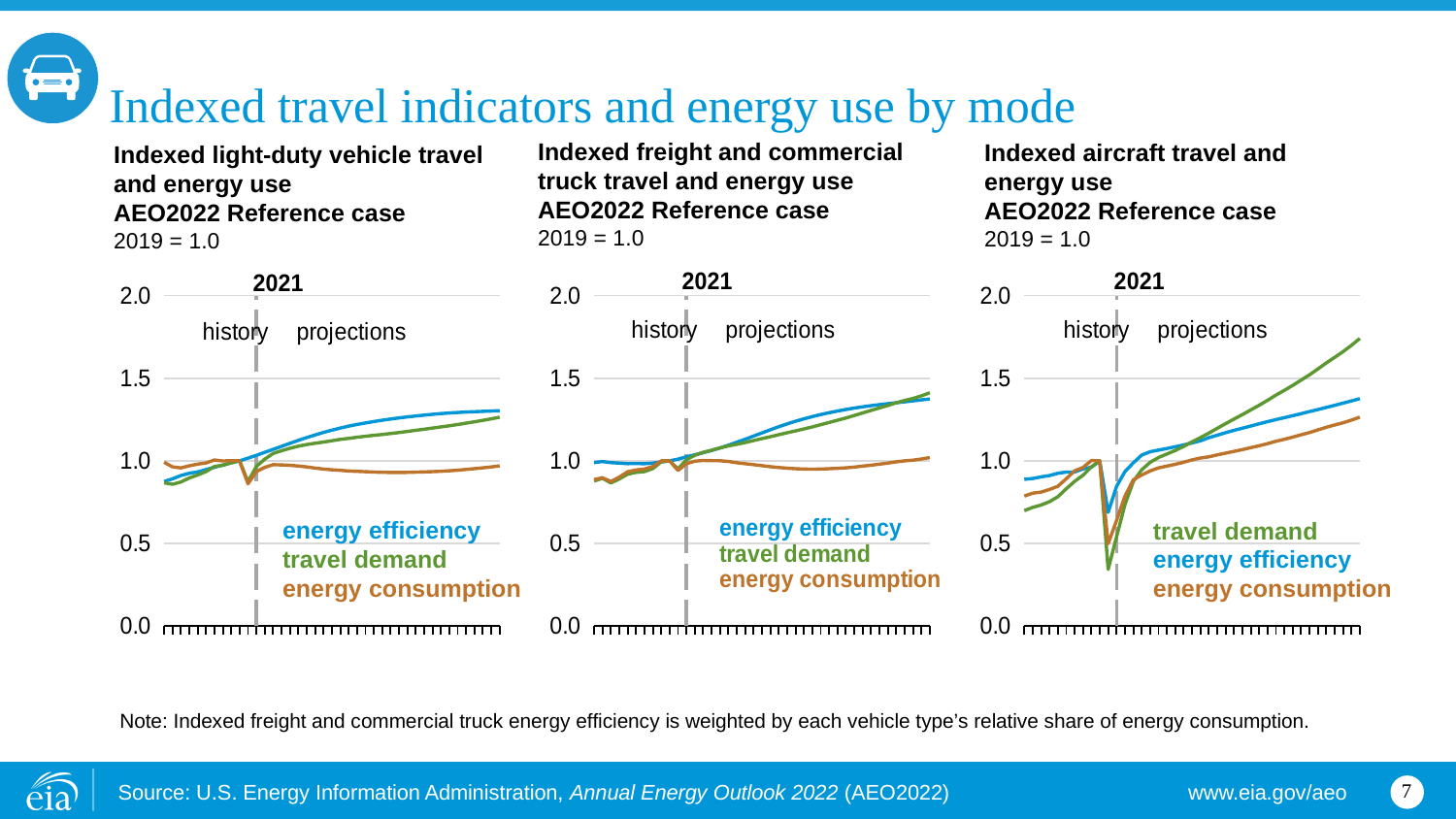
In the 'Indexed aircraft travel and energy use' chart, is the value for travel demand at the end of the projection period greater or less than 1.5? greater In the 'Indexed light-duty vehicle travel and energy use' chart, does energy efficiency rise or fall over the projection period? rise In the 'Indexed aircraft travel and energy use' chart, how many series are plotted? 3 What year does the vertical dashed line separating history from projections mark in each chart? 2021 In the 'Indexed aircraft travel and energy use' chart, at the end of the projection period, which is larger: travel demand or energy consumption? travel demand What kind of chart is the 'Indexed light-duty vehicle travel and energy use' chart? line chart In the 'Indexed freight and commercial truck travel and energy use' chart, which three series are labeled? energy efficiency, travel demand, energy consumption In the 'Indexed freight and commercial truck travel and energy use' chart, at the end of the projection period, which is larger: energy efficiency or energy consumption? energy efficiency In the 'Indexed aircraft travel and energy use' chart, which series is highest at the end of the projection period? travel demand How many charts are shown on the slide? 3 In the 'Indexed aircraft travel and energy use' chart, is the lowest value of travel demand during the history period greater or less than 0.5? less In the 'Indexed light-duty vehicle travel and energy use' chart, is the value for energy efficiency at the end of the projection period greater or less than 1.0? greater